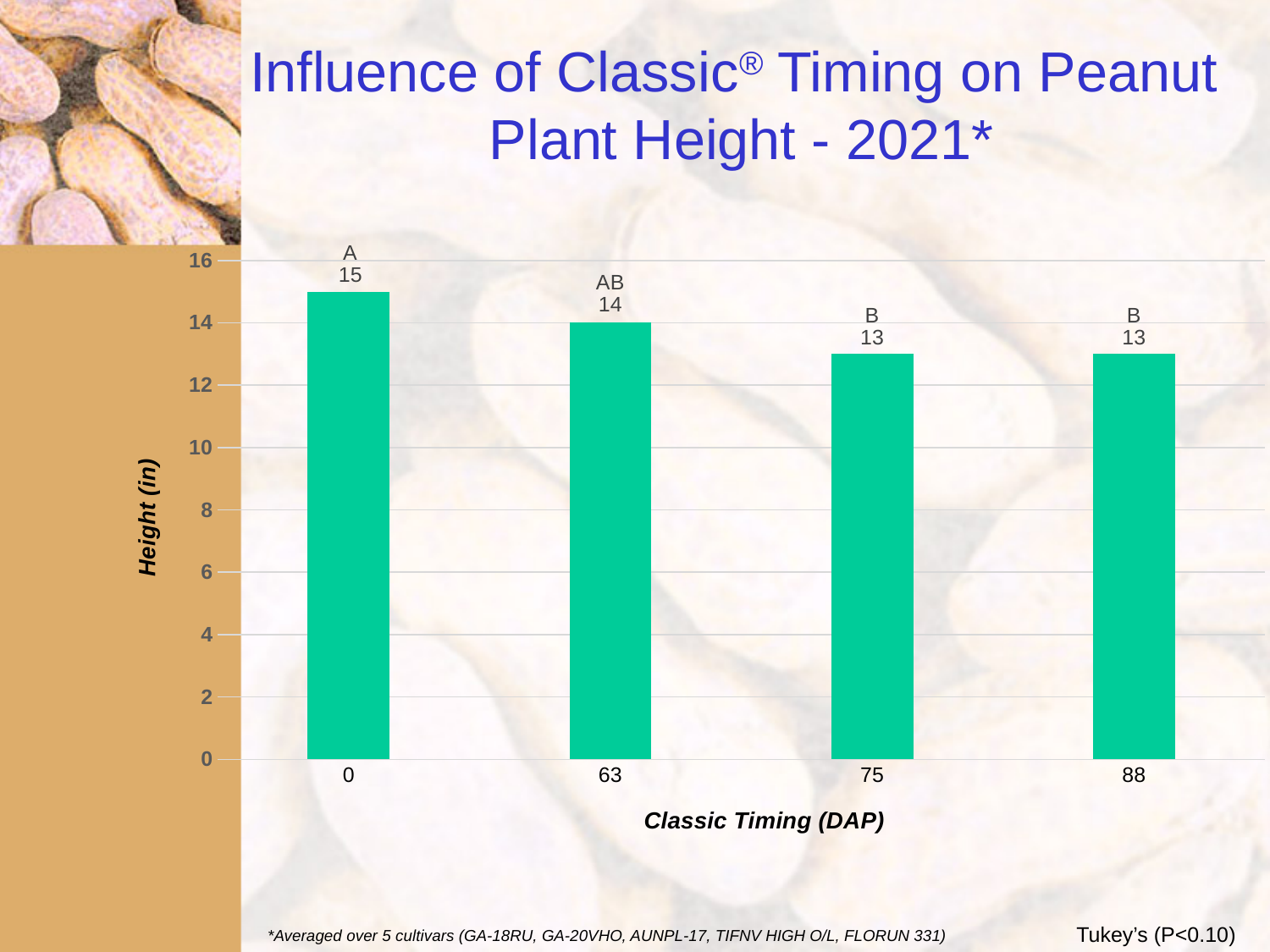
What is the difference in plant height between the 0 DAP and 88 DAP timings? 2 How many Classic timing categories are shown on the x axis? 4 What is the label of the y axis? Height (in) Which has a greater plant height, the 63 DAP timing or the 75 DAP timing? 63 Do plant heights rise or fall as Classic timing (DAP) increases along the x axis? fall Which Classic timing has the greatest plant height? 0 What is the plant height for the 75 DAP Classic timing? 13 What is the plant height for the 0 DAP Classic timing? 15 What is the plant height for the 63 DAP Classic timing? 14 What statistical letter grouping is shown above the 63 DAP bar? AB Is the plant height for the 88 DAP timing greater or less than 14? less What kind of chart is shown on the slide? bar chart